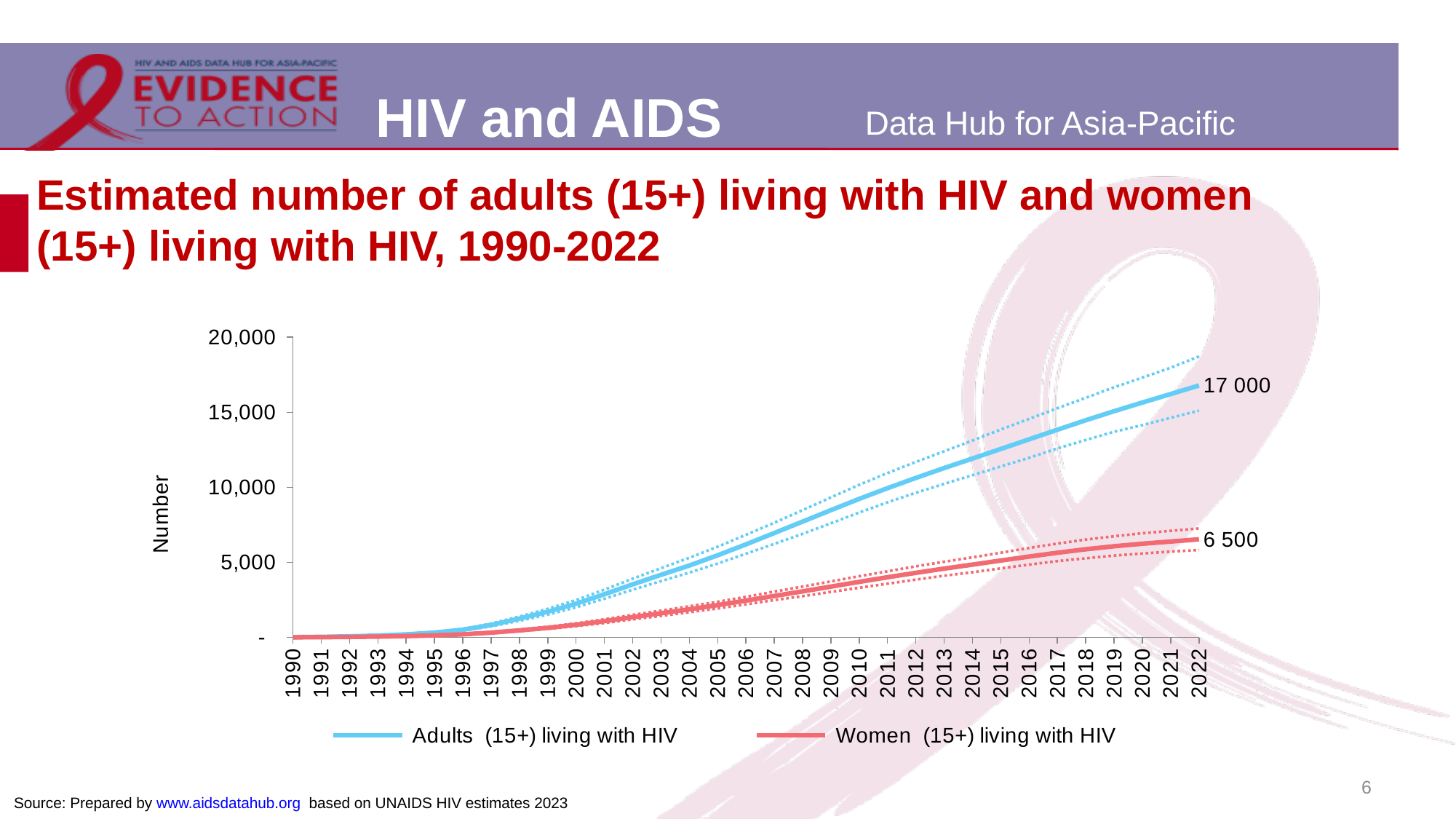
Do the values for Adults (15+) living with HIV rise or fall from 1990 to 2022? Rise How many series does the legend list? 2 What is the label on the y axis of the chart? Number Is the value for Adults (15+) living with HIV in 2015 greater or less than 10,000? greater In 2022, which series has the larger value: Adults (15+) living with HIV or Women (15+) living with HIV? Adults (15+) living with HIV Is the value for Adults (15+) living with HIV in 2000 greater or less than 5,000? less What is the estimated number of women (15+) living with HIV in 2022? 6 500 How many years are shown on the x axis of the chart? 33 What is the difference between the 2022 values for adults (15+) living with HIV and women (15+) living with HIV? 10 500 Is the value for Women (15+) living with HIV in 2010 greater or less than 5,000? less What kind of chart is shown on the slide? Line chart What is the estimated number of adults (15+) living with HIV in 2022? 17 000